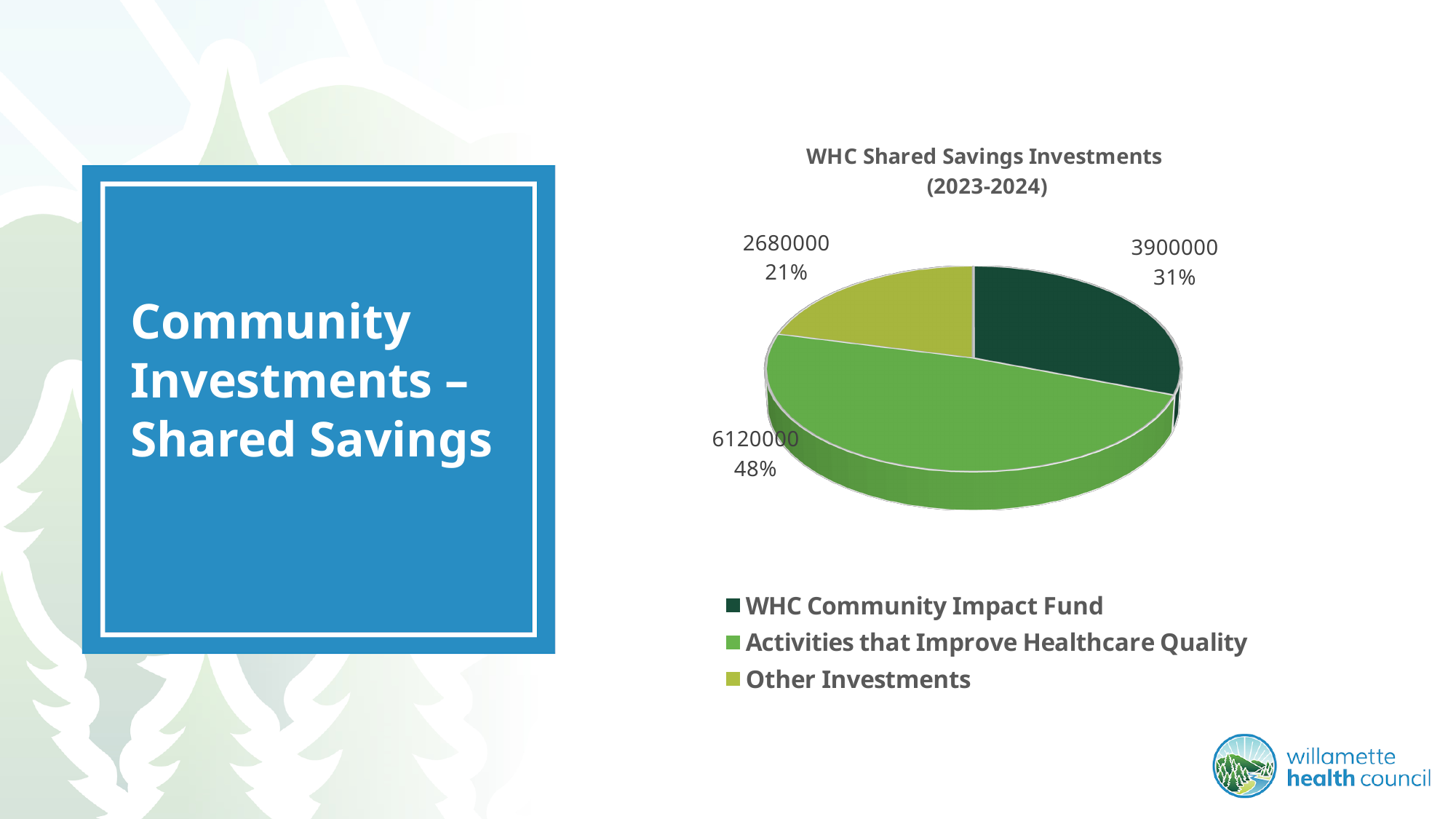
Which category has the largest slice of the pie? Activities that Improve Healthcare Quality Which category has the smallest slice of the pie? Other Investments What is the value for Other Investments? 2680000 What is the value for Activities that Improve Healthcare Quality? 6120000 What is the value for WHC Community Impact Fund? 3900000 How many categories are shown in the pie chart? 3 What is the difference between the values for Activities that Improve Healthcare Quality and WHC Community Impact Fund? 2220000 What is the title of the chart? WHC Shared Savings Investments (2023-2024) What kind of chart is shown on the slide? Pie chart Which is larger, the value for WHC Community Impact Fund or the value for Other Investments? WHC Community Impact Fund What share of the pie does WHC Community Impact Fund represent? 31% What share of the pie does Other Investments represent? 21%